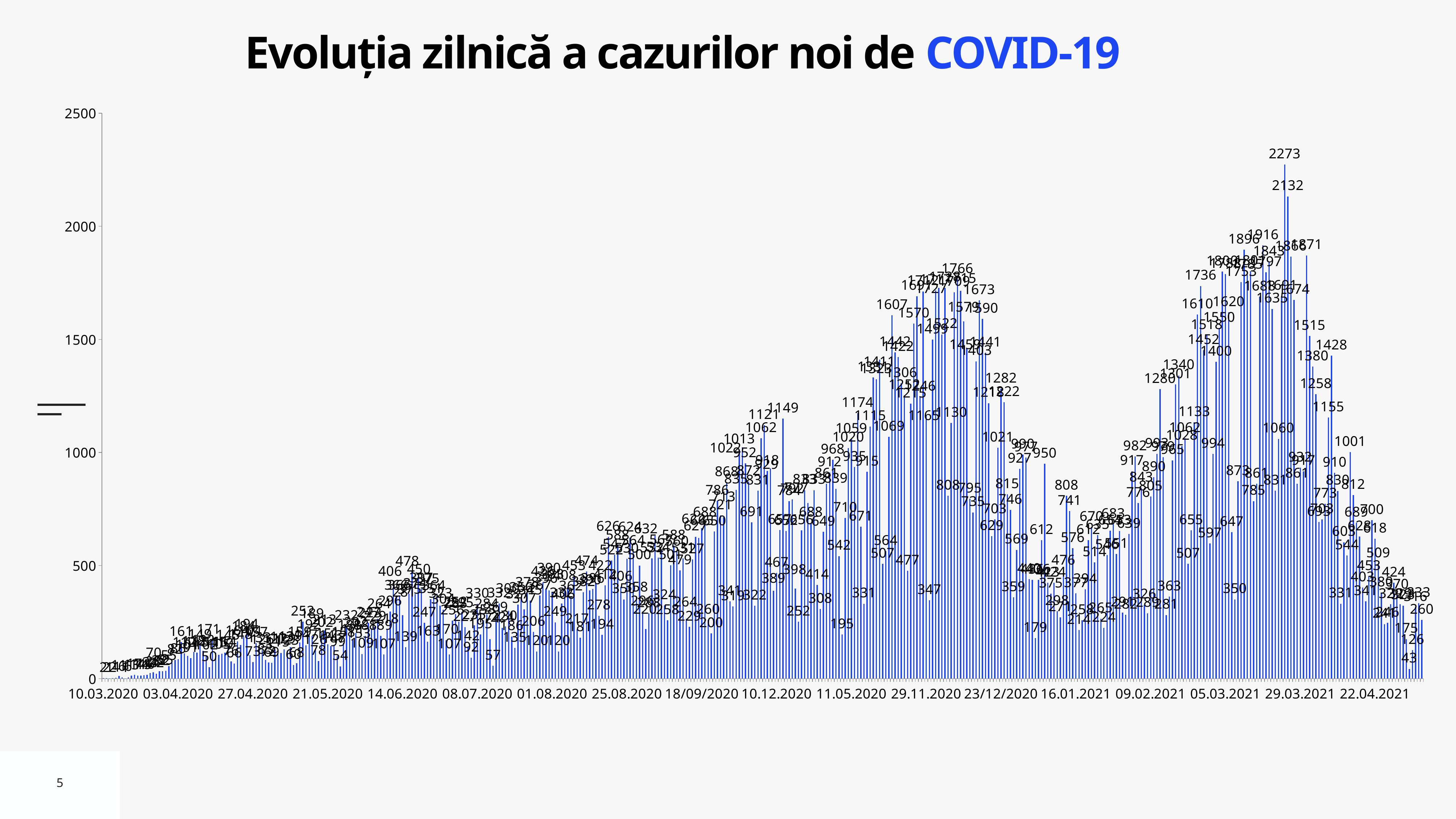
What is the difference between the two tallest bars, labelled 2273 and 2132? 141 Which is larger, the bar labelled 2273 or the bar labelled 2132? 2273 What is the title of the chart? Evoluția zilnică a cazurilor noi de COVID-19 What kind of chart is shown on the slide? Bar chart Is the value of the tallest bar greater or less than 2000? greater Do the values generally rise or fall between 29.03.2021 and 22.04.2021? fall What is the value of the second-tallest bar, next to the 2273 peak? 2132 Do the values generally rise or fall between 10.03.2020 and 14.06.2020? rise What is the maximum value shown on the vertical axis? 2500 What is the value of the last bar at the right end of the chart? 260 What is the highest daily value shown on the chart? 2273 Is the value of the last bar on the right greater or less than 500? less